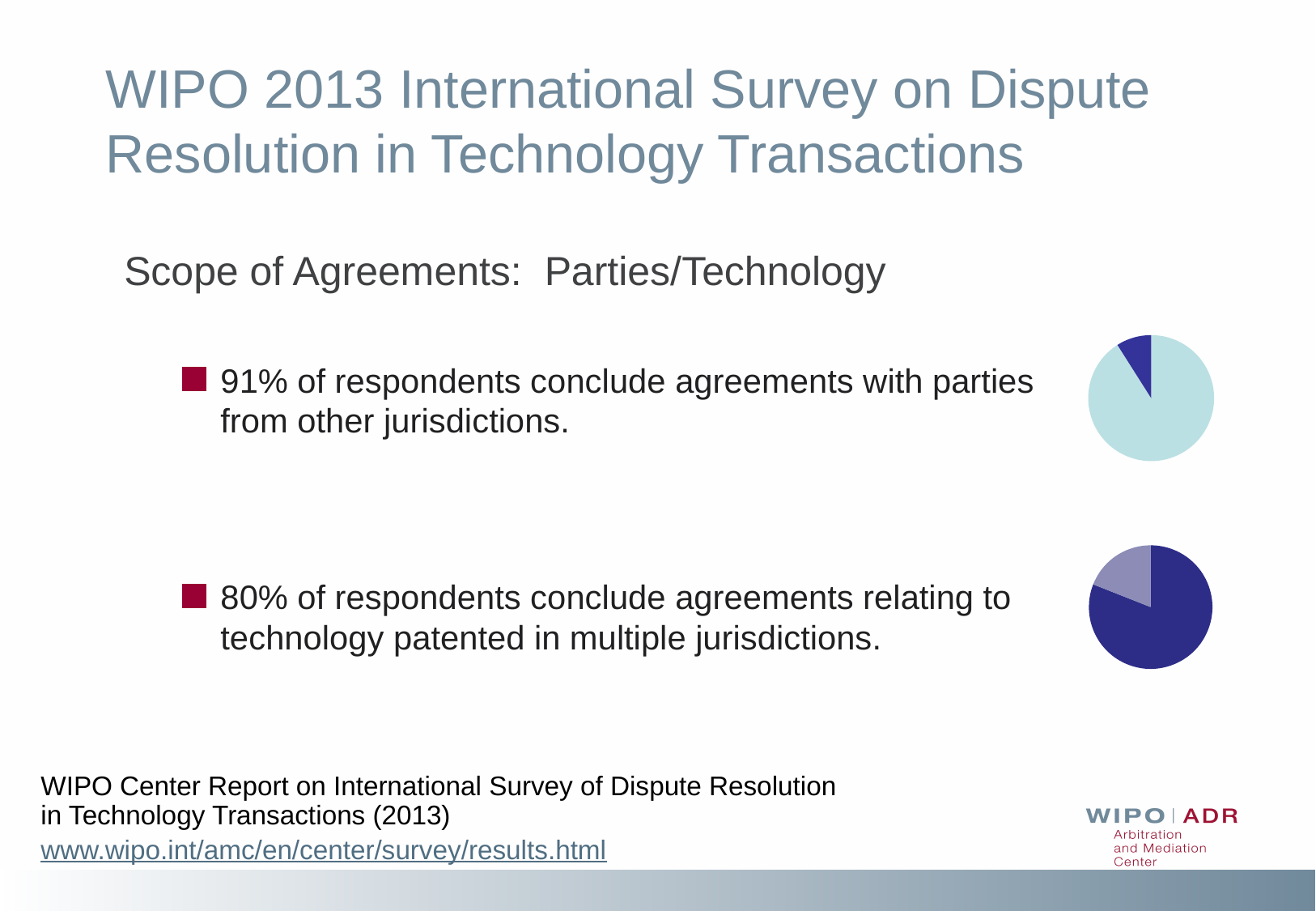
In the bottom pie chart, which slice is larger, the dark blue one or the light purple one? the dark blue one How many charts are shown on the slide? 2 What kind of chart is the bottom chart on the right of the slide? pie chart In the top pie chart, next to the bullet about parties from other jurisdictions, what share of respondents does the large slice represent? 91% What kind of chart is the top chart on the right of the slide? pie chart Which pie chart has the larger majority slice, the top one or the bottom one? the top one In the top pie chart, how many slices are there? 2 In the bottom pie chart, how many slices are there? 2 In the top pie chart, which slice is larger, the light teal one or the dark blue one? the light teal one What colour is the small slice in the top pie chart? dark blue Do either of the pie charts on the slide show a legend? No